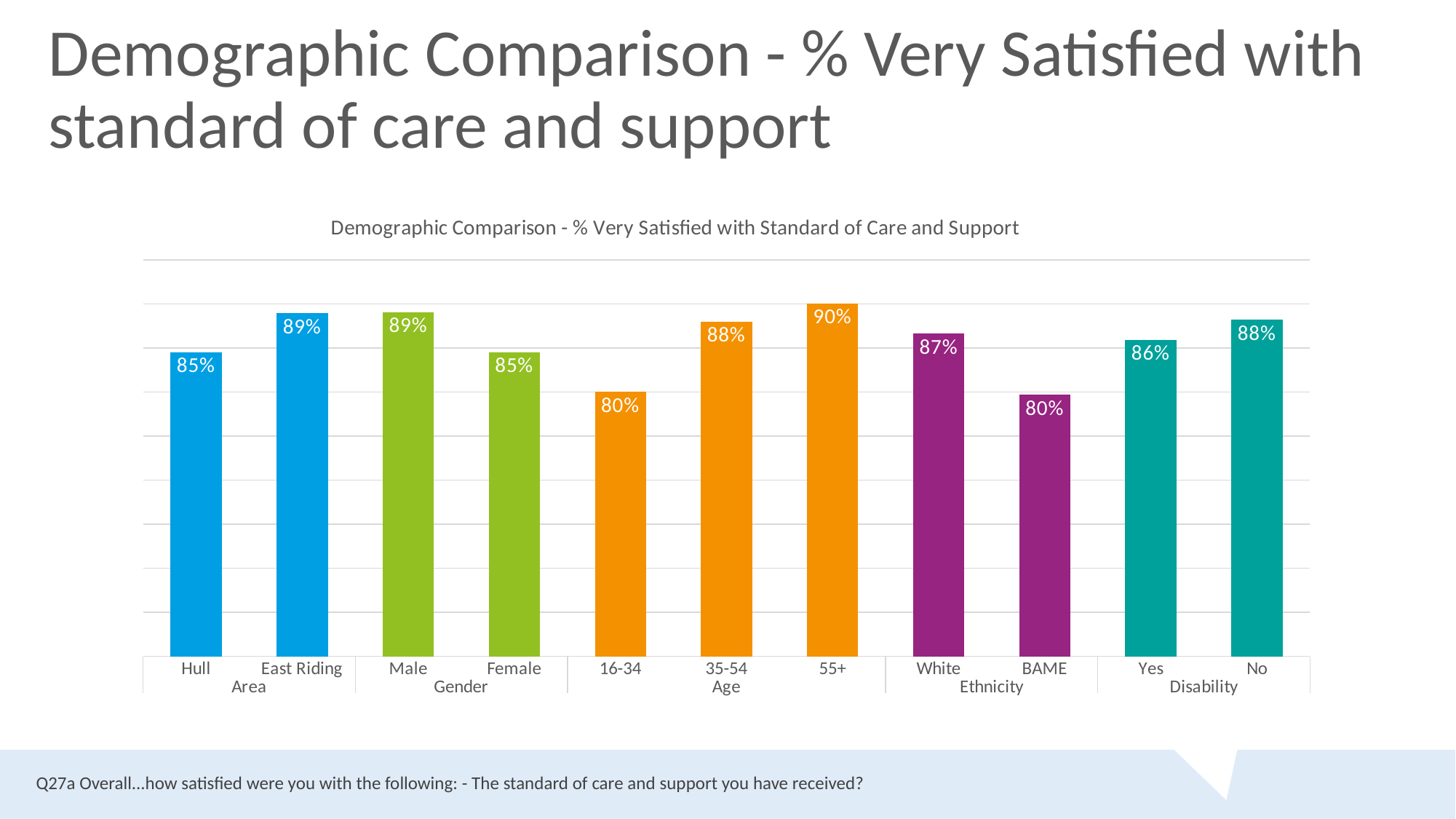
Which is larger, the value for Male or the value for Female? Male What is the title of the chart? Demographic Comparison - % Very Satisfied with Standard of Care and Support Which age group has the lowest value? 16-34 What is the difference between the values for White and BAME? 7% What is the value for the 55+ age group? 90% How many bars are plotted in the chart? 11 What kind of chart is shown? Bar chart What is the difference between the values for East Riding and Hull? 4% What is the value for Hull? 85% What is the value for Yes under Disability? 86% Which category has the highest value? 55+ What is the value for BAME? 80%